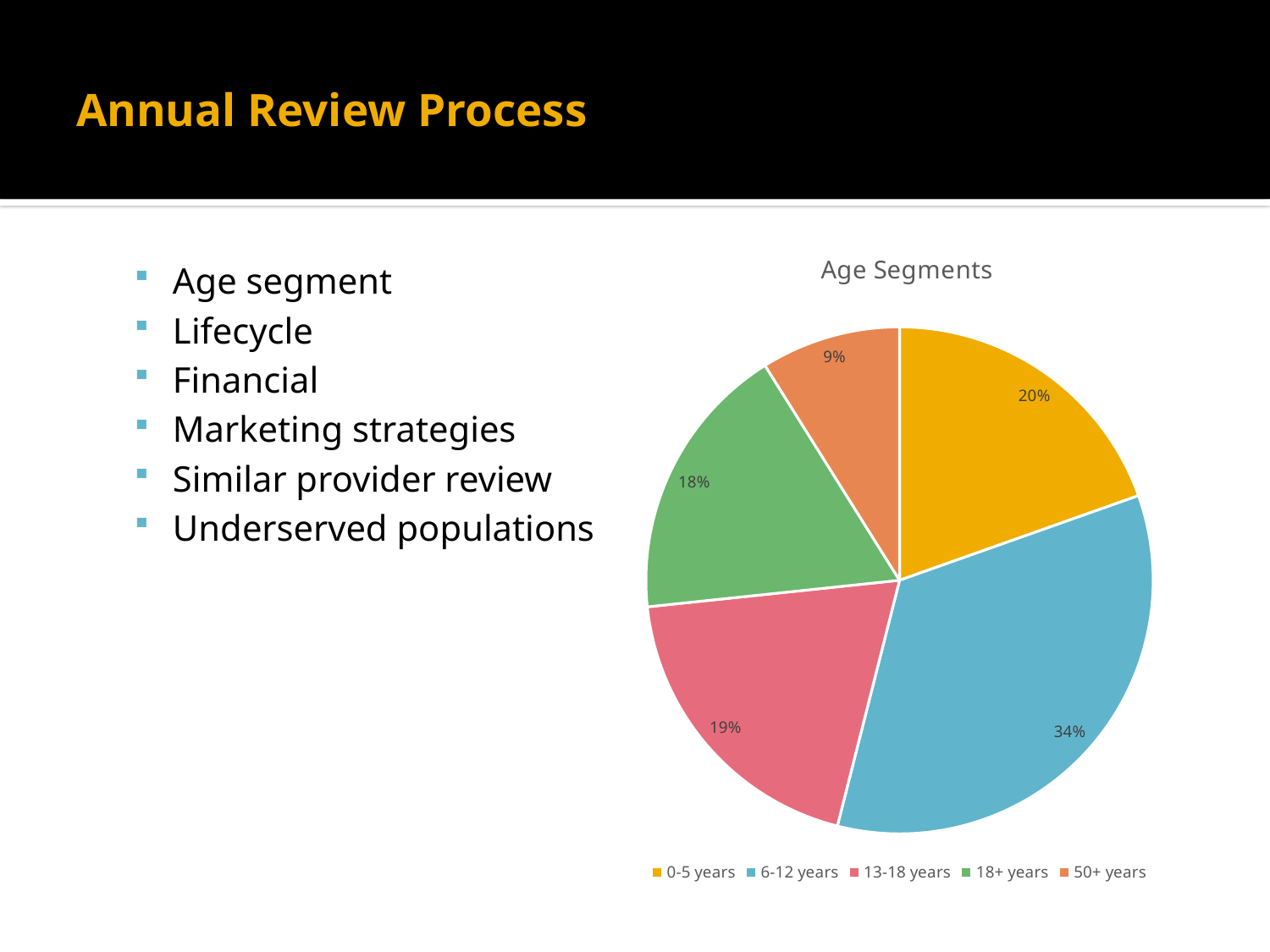
Which age segment has the smallest share of the pie? 50+ years Which age segment has the largest share of the pie? 6-12 years What is the value shown for the 0-5 years slice? 20% How many slices does the pie chart have? 5 What is the title of the chart? Age Segments What is the value shown for the 50+ years slice? 9% What is the value shown for the 18+ years slice? 18% What share of the pie does the 6-12 years segment represent? 34% What colour is the 6-12 years slice? blue What type of chart is shown on the slide? pie chart Which is larger, the 13-18 years slice or the 50+ years slice? 13-18 years What is the difference in percentage points between the 6-12 years slice and the 0-5 years slice? 14